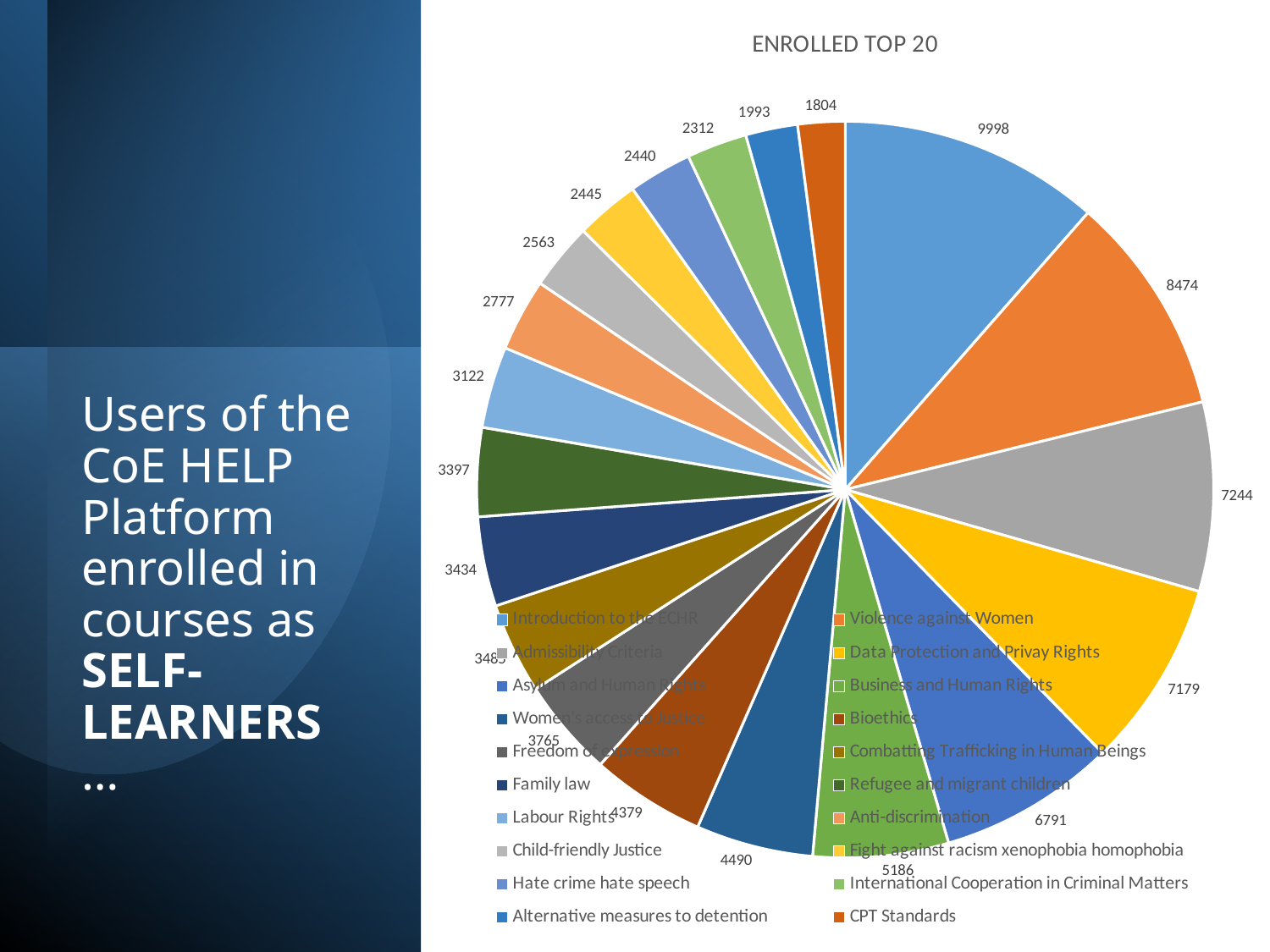
Which course has the smallest slice in the pie chart? CPT Standards What is the difference between the largest slice (9998) and the second largest slice (8474)? 1524 How many slices does the pie chart have? 20 What is the difference between the slices labelled 4490 and 4379? 111 What is the value of the smallest slice in the pie chart? 1804 Which course has the largest slice in the pie chart? Introduction to the ECHR Which is larger, the slice labelled 6791 or the slice labelled 5186? 6791 What type of chart is shown on the slide? pie chart What is the enrolment value for Admissibility Criteria? 7244 What is the title of the chart? ENROLLED TOP 20 What is the value of the largest slice in the pie chart? 9998 What is the enrolment value for Violence against Women? 8474